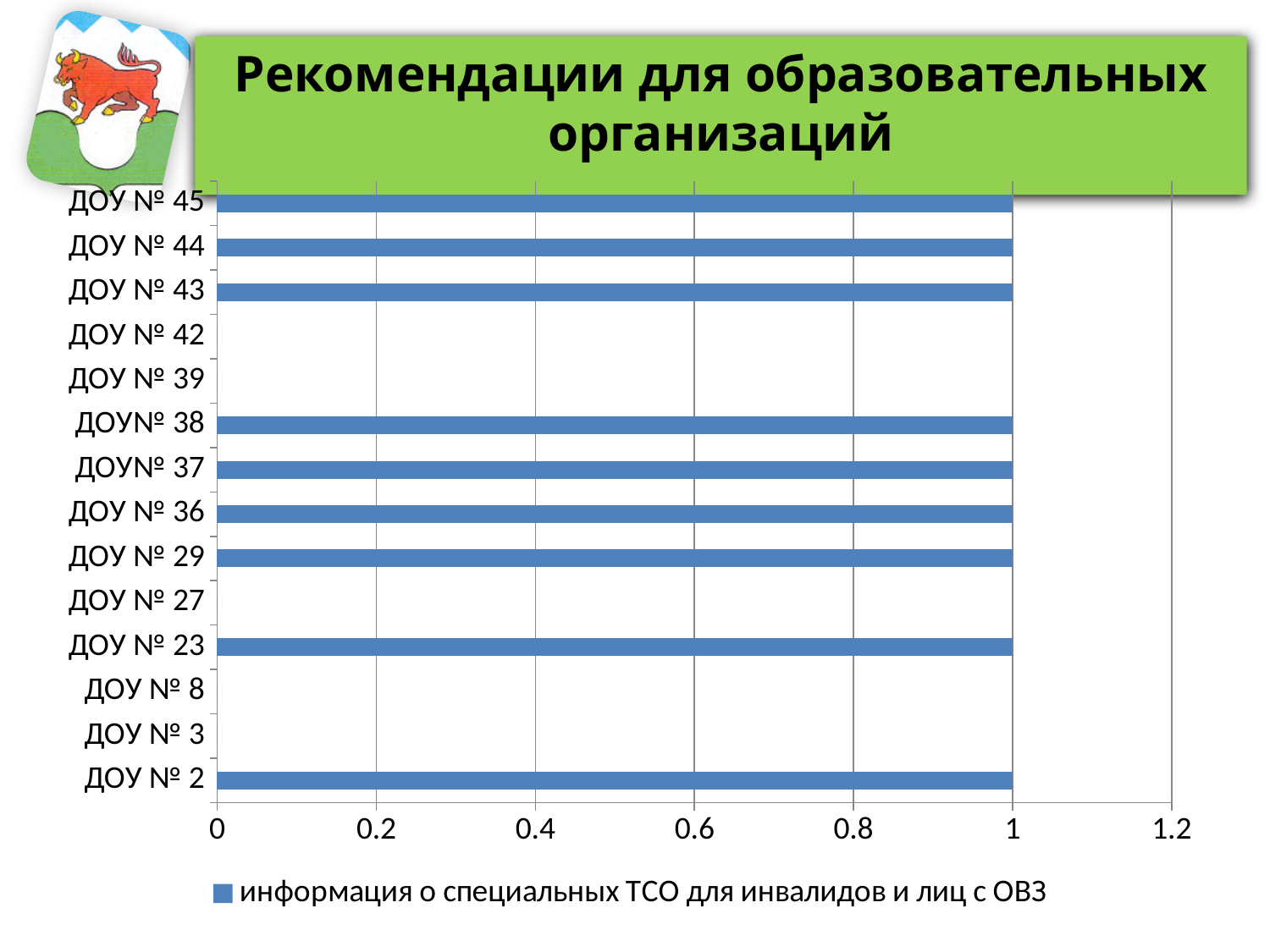
How many series does the chart legend list? 1 What is the difference between the value for ДОУ № 44 and the value for ДОУ № 39? 1 Is the value for ДОУ № 36 greater or less than 0.8? greater What kind of chart is shown on the slide? bar chart How many categories (ДОУ) are listed on the vertical axis of the chart? 14 What is the value for ДОУ № 2 in the chart? 1 Which is larger in the chart, the value for ДОУ № 27 or the value for ДОУ № 29? ДОУ № 29 Which is larger in the chart, the value for ДОУ № 43 or the value for ДОУ № 42? ДОУ № 43 What is the legend entry of the series plotted in the chart? информация о специальных ТСО для инвалидов и лиц с ОВЗ Is the value for ДОУ № 8 greater or less than 0.2? less What is the value for ДОУ № 23 in the chart? 1 What is the value for ДОУ № 45 in the chart? 1